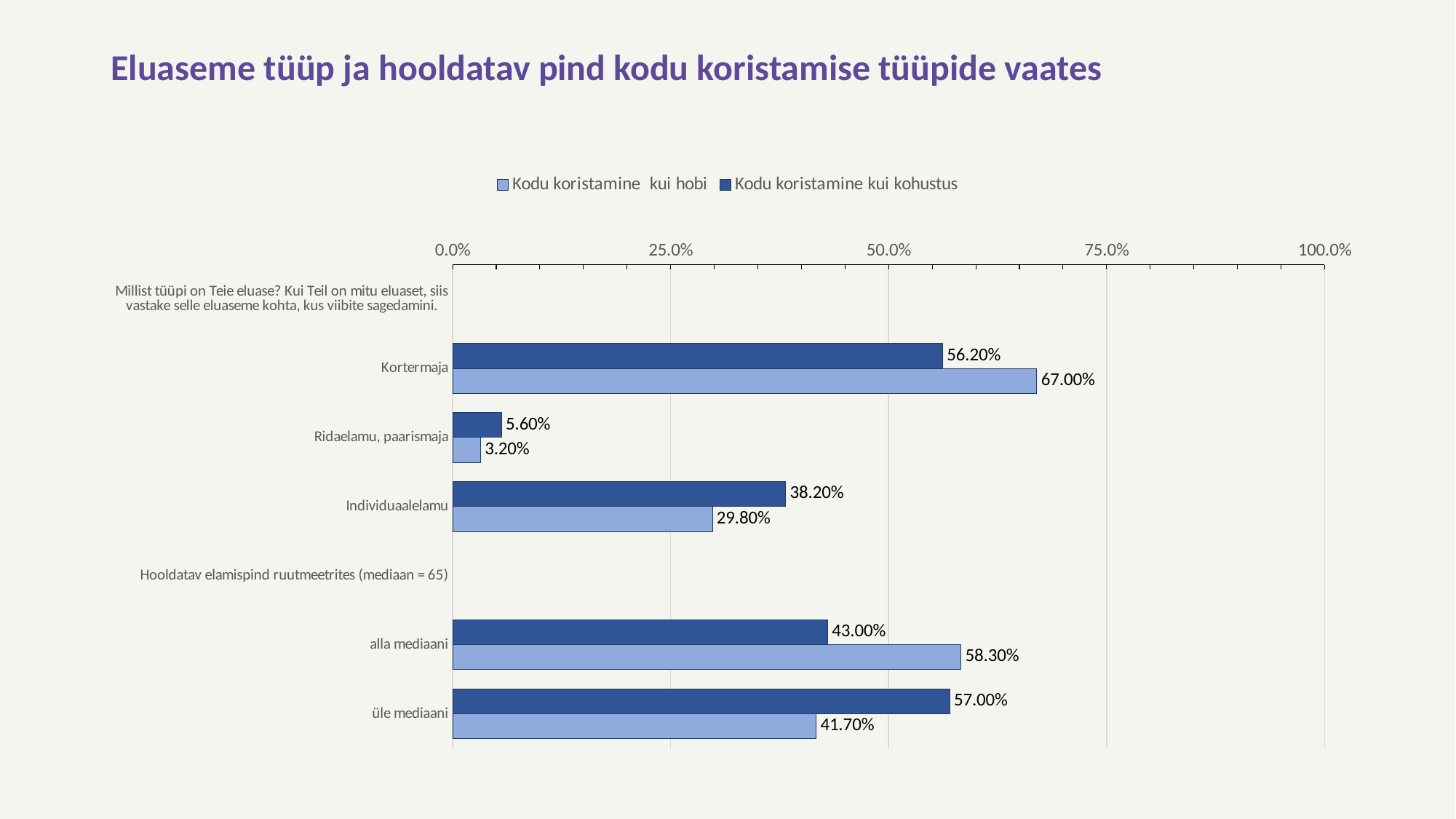
Is the 'Kodu koristamine kui kohustus' value for Individuaalelamu greater or less than 50.0%? less What is the difference between the 'Kodu koristamine kui kohustus' and 'Kodu koristamine kui hobi' values for alla mediaani? 15.30% How many series does the legend list? 2 What is the value for üle mediaani in the 'Kodu koristamine kui hobi' series? 41.70% Which category has the lowest value in the 'Kodu koristamine kui kohustus' series? Ridaelamu, paarismaja Which category has the highest value in the 'Kodu koristamine kui hobi' series? Kortermaja What is the value for Kortermaja in the 'Kodu koristamine kui hobi' series? 67.00% For üle mediaani, which series has the larger value: 'Kodu koristamine kui hobi' or 'Kodu koristamine kui kohustus'? Kodu koristamine kui kohustus What is the value for Individuaalelamu in the 'Kodu koristamine kui kohustus' series? 38.20% What is the title of the slide? Eluaseme tüüp ja hooldatav pind kodu koristamise tüüpide vaates What kind of chart is shown on the slide? Bar chart What is the difference between the 'Kodu koristamine kui hobi' and 'Kodu koristamine kui kohustus' values for Kortermaja? 10.80%